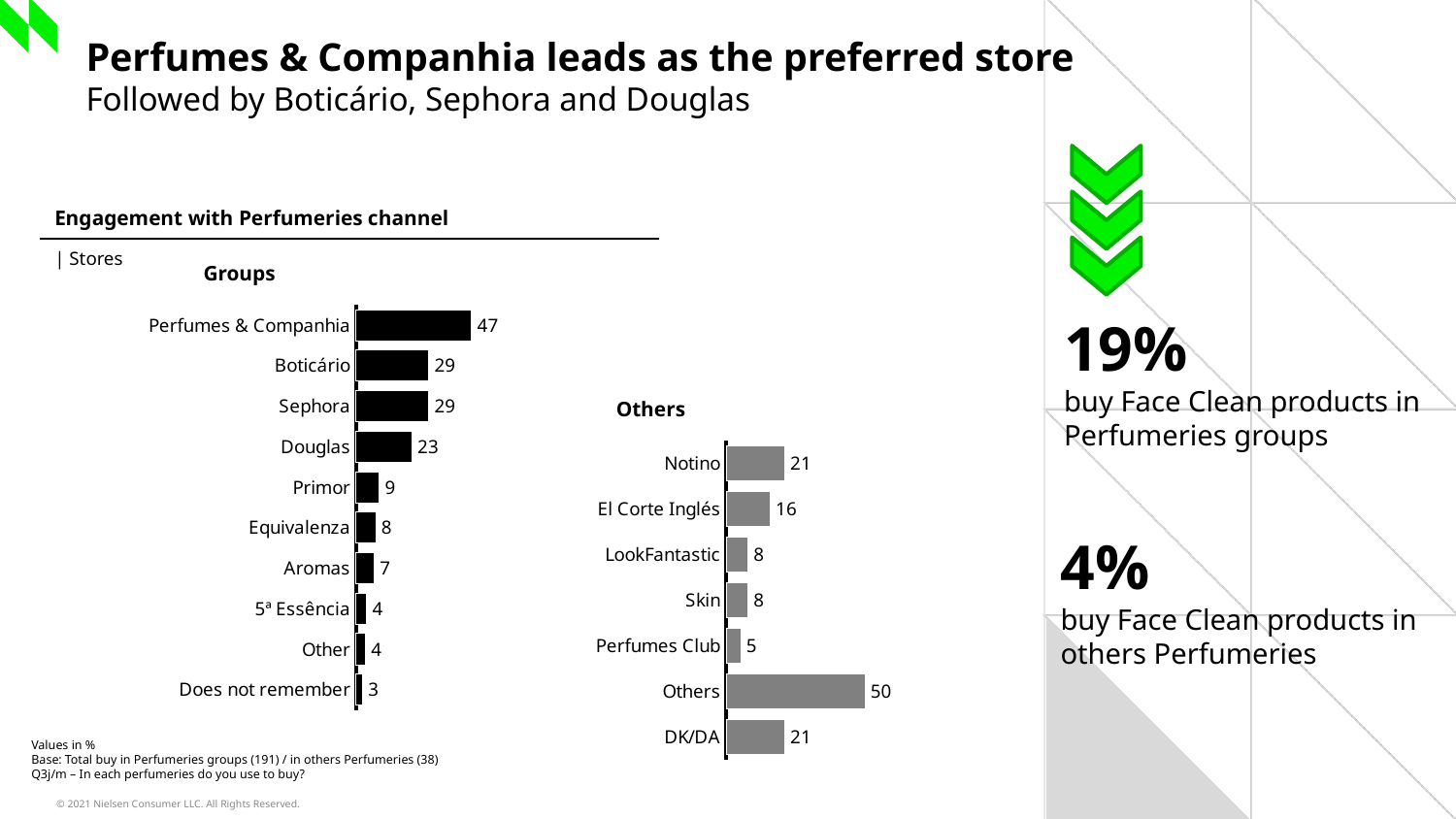
In the Groups chart, what is the value for Perfumes & Companhia? 47 What type of chart is the Groups chart? Bar chart How many categories are shown in the Groups chart? 10 In the Others chart, which is larger, Notino or LookFantastic? Notino How many categories are shown in the Others chart? 7 In the Groups chart, what is the value for Douglas? 23 In the Groups chart, which category has the lowest value? Does not remember In the Groups chart, what is the difference between Perfumes & Companhia and Boticário? 18 In the Others chart, what is the value for El Corte Inglés? 16 In the Groups chart, which category has the highest value? Perfumes & Companhia In the Others chart, which category has the highest value? Others In the Others chart, what is the value for Perfumes Club? 5